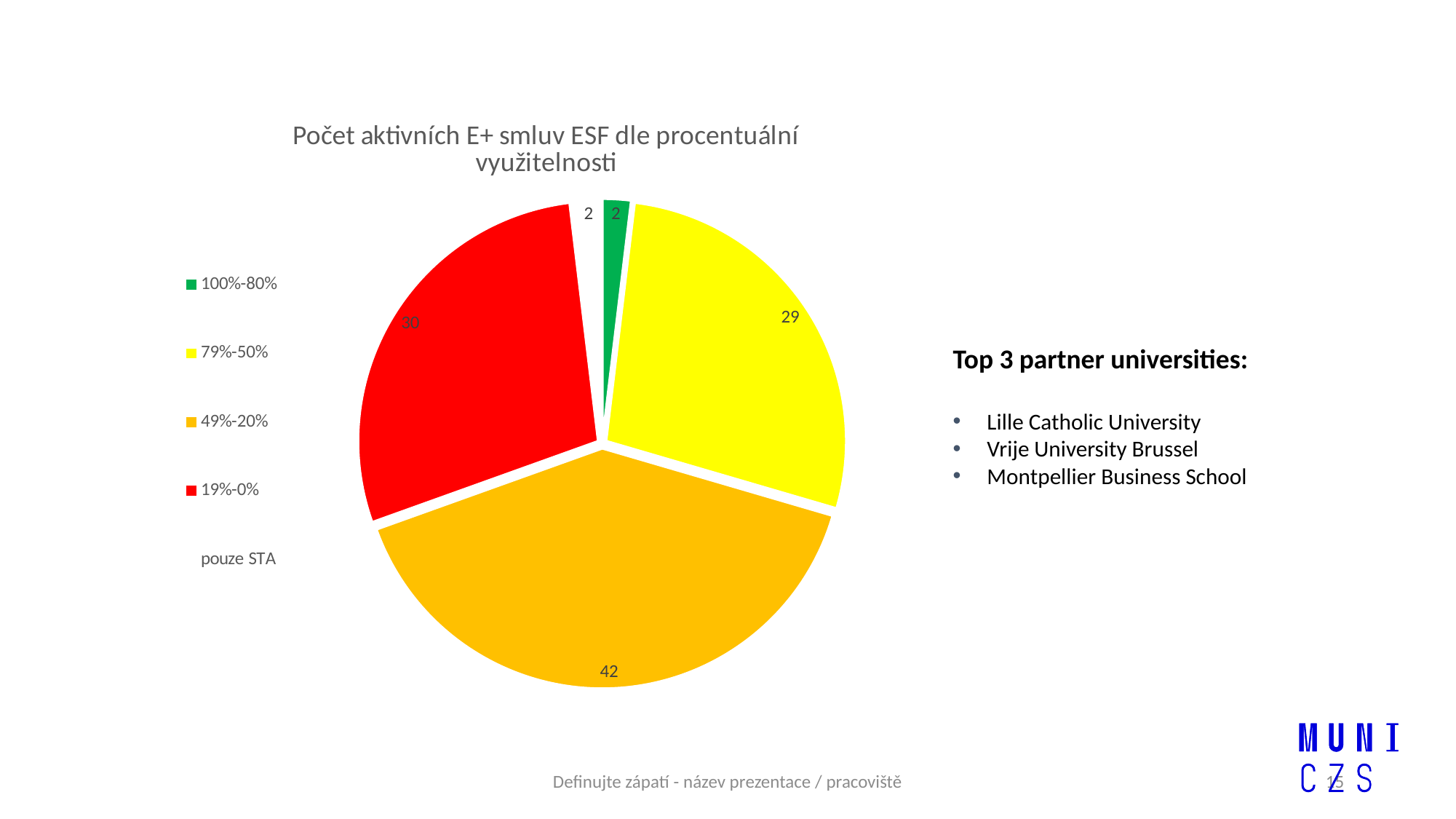
What is the difference between the values for 49%-20% and 19%-0%? 12 How many slices does the pie chart have? 5 What kind of chart is shown on the slide? pie chart What is the total of all the values shown on the pie chart? 105 What share of the pie does the 49%-20% slice represent? 40% Which category has the largest slice of the pie? 49%-20% What is the value for the 100%-80% category? 2 What is the value for the 19%-0% category? 30 What is the value for the 49%-20% category? 42 Which is larger, the value for 19%-0% or the value for 79%-50%? 19%-0% What is the value for the 79%-50% category? 29 What is the title of the chart? Počet aktivních E+ smluv ESF dle procentuální využitelnosti